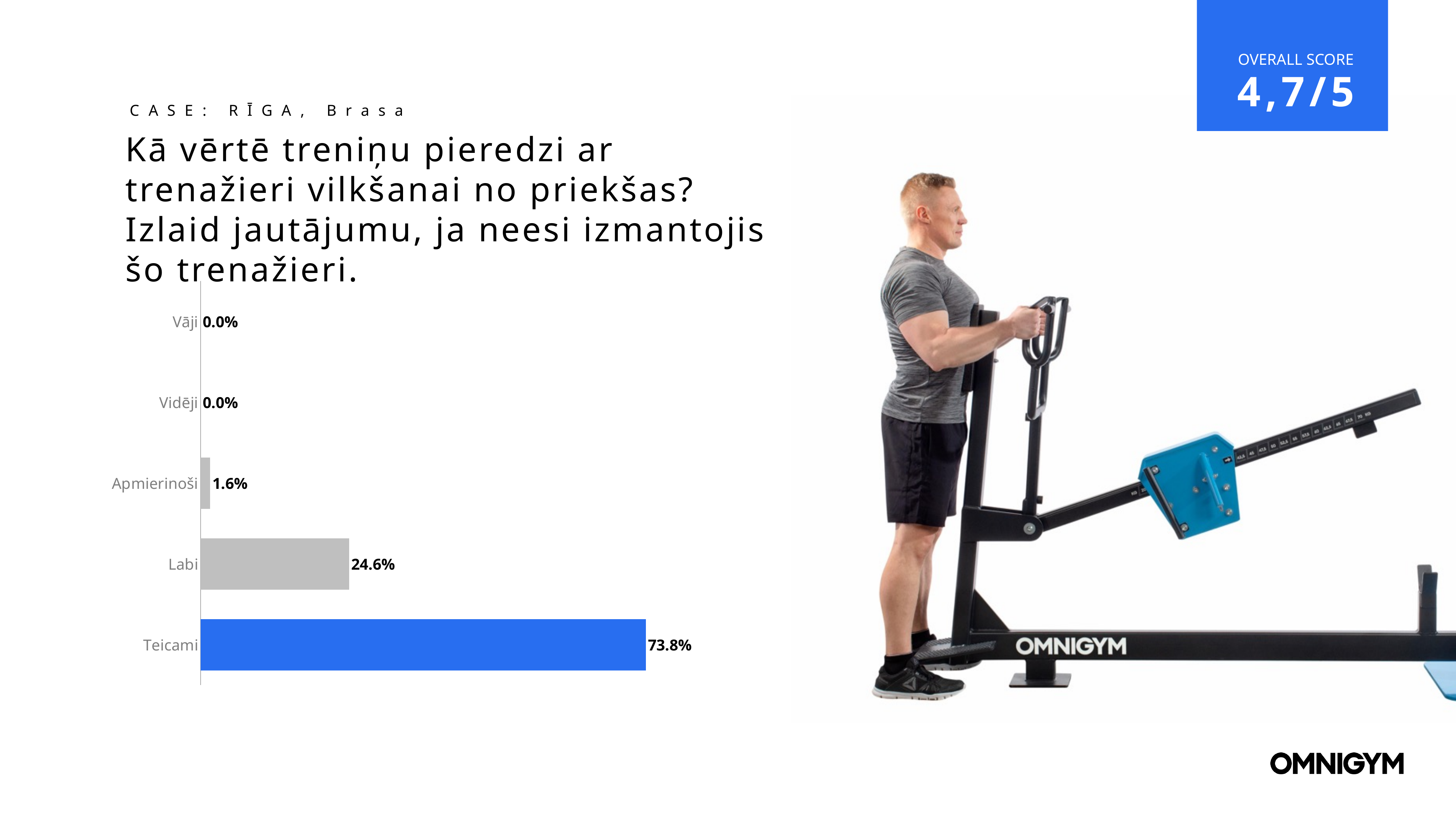
How many categories are shown in the chart? 5 What kind of chart is shown on the slide? bar chart Which category's bar is coloured blue? Teicami What is the difference between the values for Labi and Apmierinoši? 23.0% What overall score is shown on the slide? 4,7/5 What is the difference between the values for Teicami and Labi? 49.2% What is the value for Vāji? 0.0% Which category has the highest value? Teicami What is the value for Labi? 24.6% What is the value for Teicami? 73.8% Which is larger, the value for Labi or the value for Apmierinoši? Labi What is the value for Apmierinoši? 1.6%